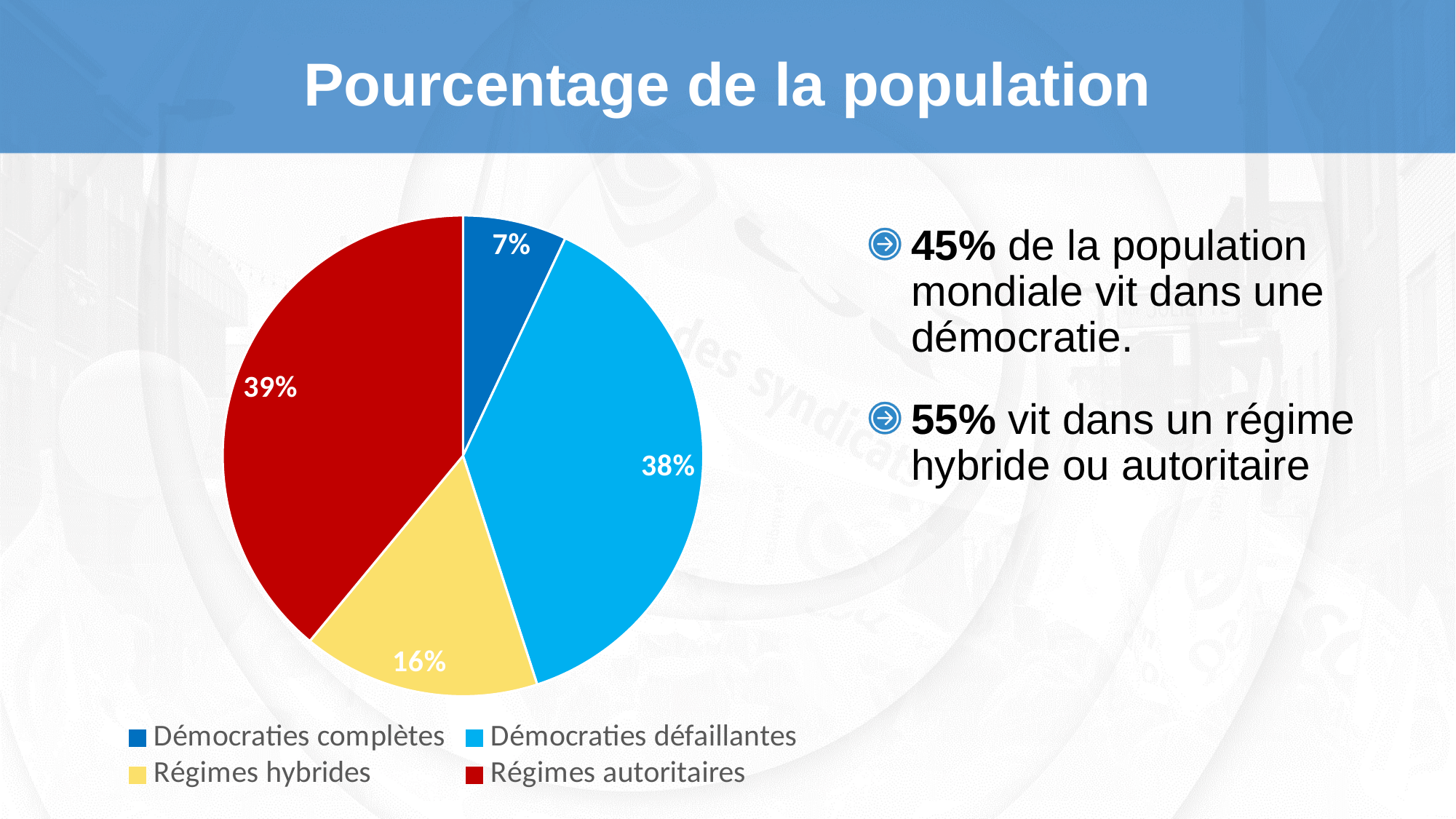
What is the combined share of Démocraties complètes and Démocraties défaillantes? 45% Which category has the smallest slice in the pie chart? Démocraties complètes Which slice is larger: Démocraties défaillantes or Régimes hybrides? Démocraties défaillantes What is the title of the slide containing the chart? Pourcentage de la population What percentage of the pie chart is labelled for Démocraties défaillantes? 38% What colour is the slice for Régimes autoritaires? Red How many categories does the pie chart show? 4 What kind of chart is shown on the slide? Pie chart What percentage of the pie chart is labelled for Démocraties complètes? 7% What percentage of the pie chart is labelled for Régimes autoritaires? 39% What is the difference in percentage points between Régimes autoritaires and Régimes hybrides? 23 What percentage of the pie chart is labelled for Régimes hybrides? 16%